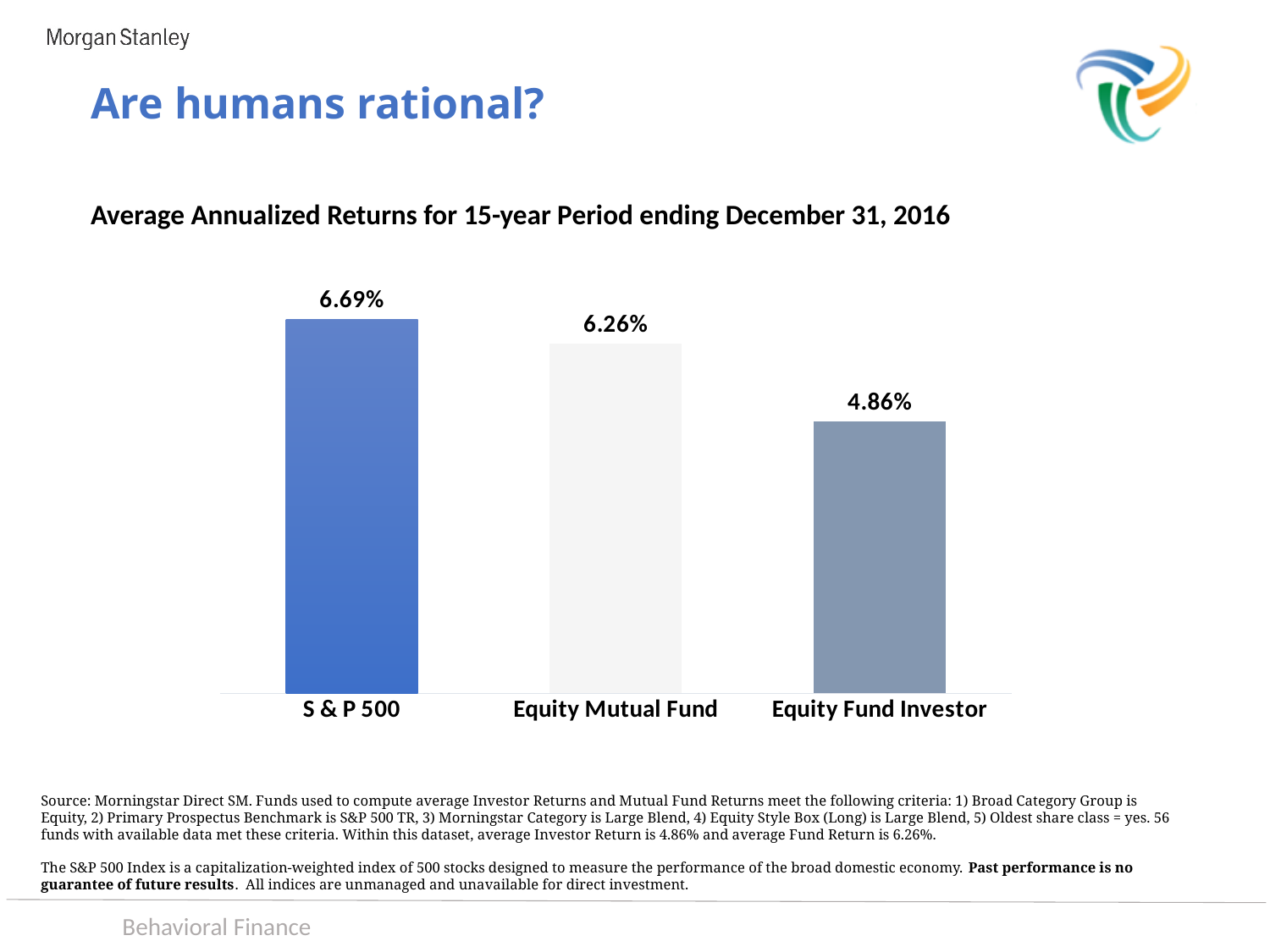
What is the average annualized return shown for S & P 500? 6.69% What is the average annualized return shown for Equity Fund Investor? 4.86% Which category has the lowest average annualized return? Equity Fund Investor What is the difference between the Equity Mutual Fund return and the Equity Fund Investor return? 1.40% How many categories are shown in the chart? 3 What is the average annualized return shown for Equity Mutual Fund? 6.26% Do the values rise or fall from left to right across the categories? Fall What is the difference between the S & P 500 return and the Equity Fund Investor return? 1.83% Which is larger, the return for Equity Mutual Fund or for Equity Fund Investor? Equity Mutual Fund What kind of chart is shown on the slide? Bar chart Which category has the highest average annualized return? S & P 500 What is the title of the chart? Average Annualized Returns for 15-year Period ending December 31, 2016